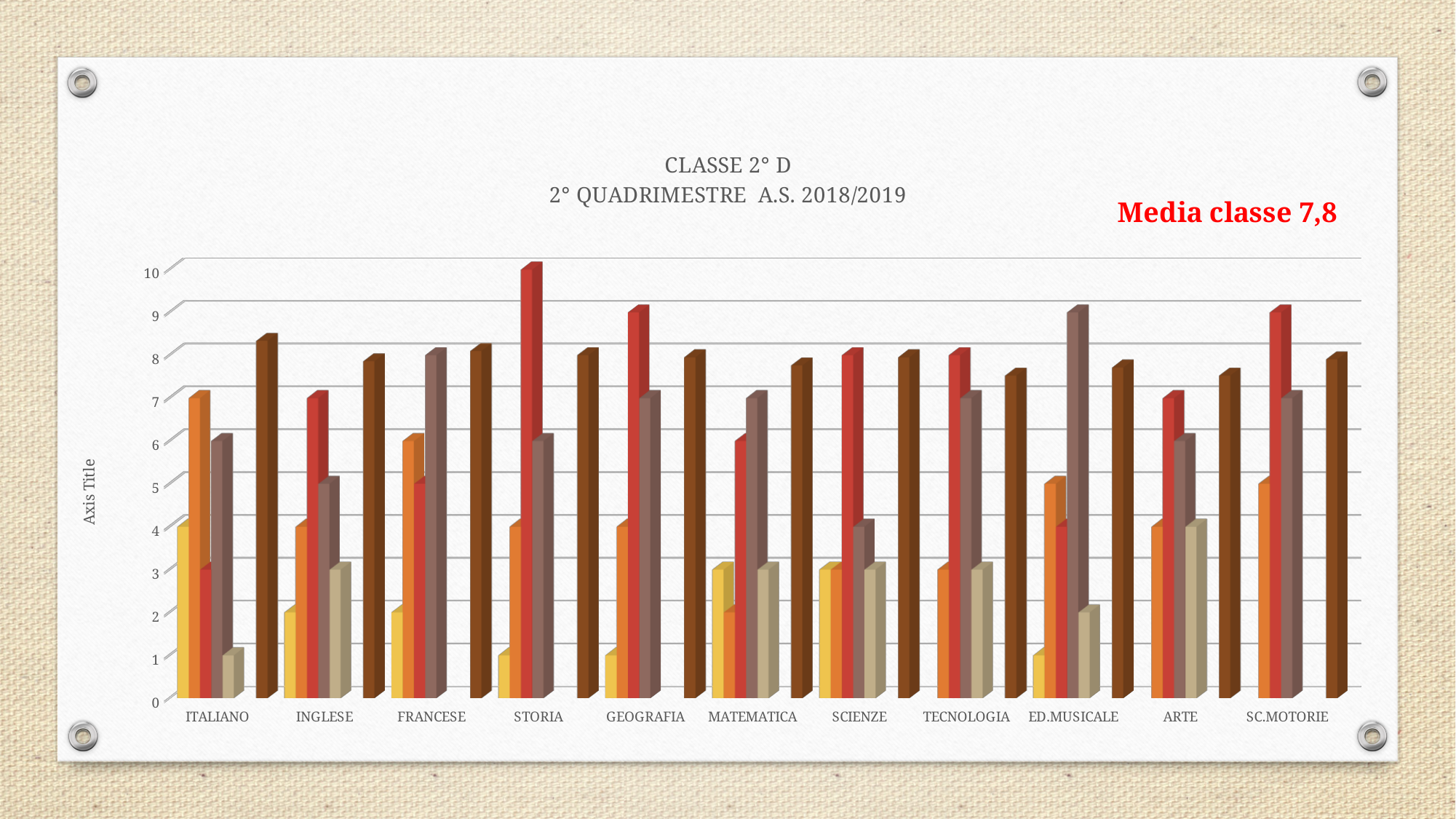
Is the tallest bar for INGLESE greater or less than 9? less What is the highest value shown on the vertical axis? 10 Which category contains the tallest bar in the chart? STORIA Is the shortest bar for ITALIANO greater or less than 2? less How many subject categories are shown along the x axis? 11 What kind of chart is shown on the slide? bar chart Is the tallest bar for STORIA greater or less than 9? greater What class average (Media classe) is printed in red on the slide? 7,8 What value does the tallest bar for STORIA reach? 10 What is the title of the chart? CLASSE 2° D 2° QUADRIMESTRE A.S. 2018/2019